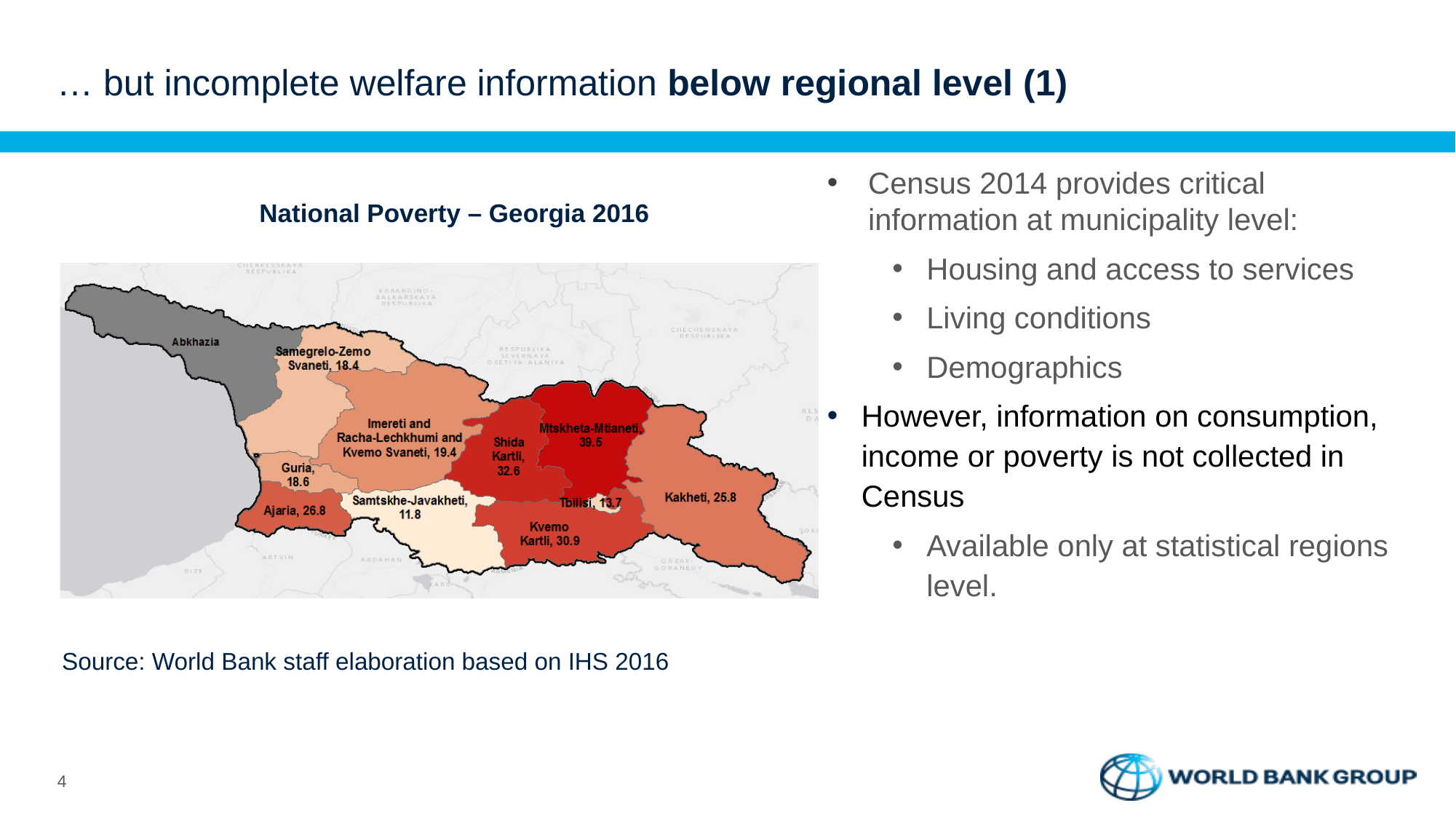
Which region on the map has the lowest poverty value? Samtskhe-Javakheti What is the poverty value shown for Samtskhe-Javakheti? 11.8 How many regions on the map have a poverty value printed? 10 What is the poverty value shown for Mtskheta-Mtianeti? 39.5 What is the difference between the poverty values of Mtskheta-Mtianeti and Tbilisi? 25.8 Which region on the map has the highest poverty value? Mtskheta-Mtianeti What is the difference between the poverty values of Shida Kartli and Kvemo Kartli? 1.7 What is the poverty value shown for Kakheti? 25.8 Which has a higher poverty value, Ajaria or Kakheti? Ajaria What is the poverty value shown for Tbilisi? 13.7 What kind of chart is shown on the slide? Map (choropleth map) What is the title of the chart on the slide? National Poverty – Georgia 2016